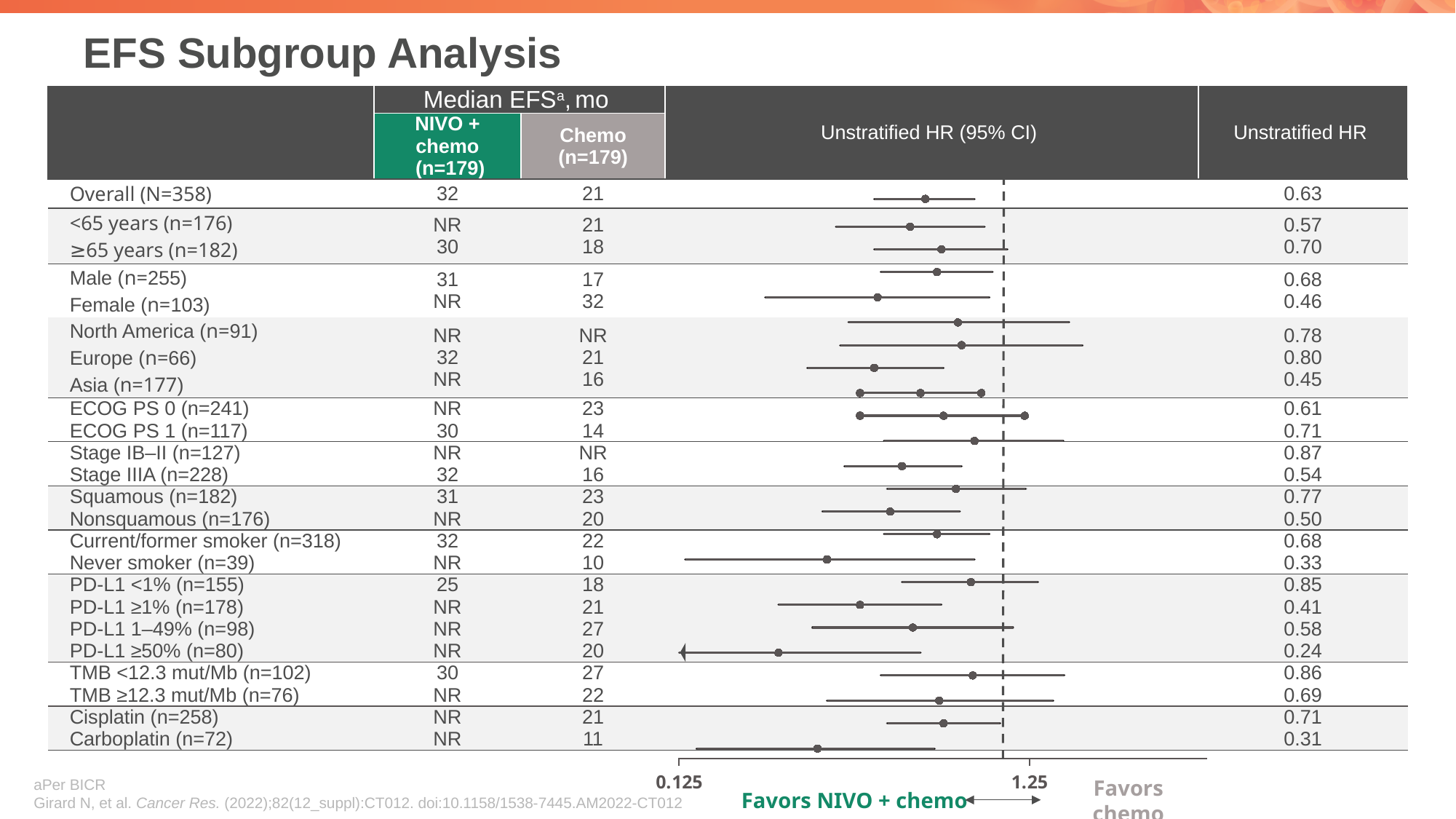
Which has the larger unstratified HR, Male (n=255) or Female (n=103)? Male (n=255) What is the unstratified HR for the Overall (N=358) group? 0.63 Is the unstratified HR point estimate for PD-L1 <1% (n=155) greater or less than 1.25? less What is the median EFS in months for the chemo arm in the Carboplatin (n=72) subgroup? 11 How many rows (including Overall) are plotted in the forest plot? 24 Which subgroup has the highest unstratified HR? Stage IB–II (n=127) What does the left side of the HR axis favor, according to the label below the plot? NIVO + chemo What is the difference in median EFS (months) between NIVO + chemo and chemo for the Overall group? 11 What kind of chart is shown on the slide? forest plot What are the two tick values labelled on the HR axis? 0.125 and 1.25 Which subgroup has the lowest unstratified HR? PD-L1 ≥50% (n=80) What is the unstratified HR for Never smoker (n=39)? 0.33